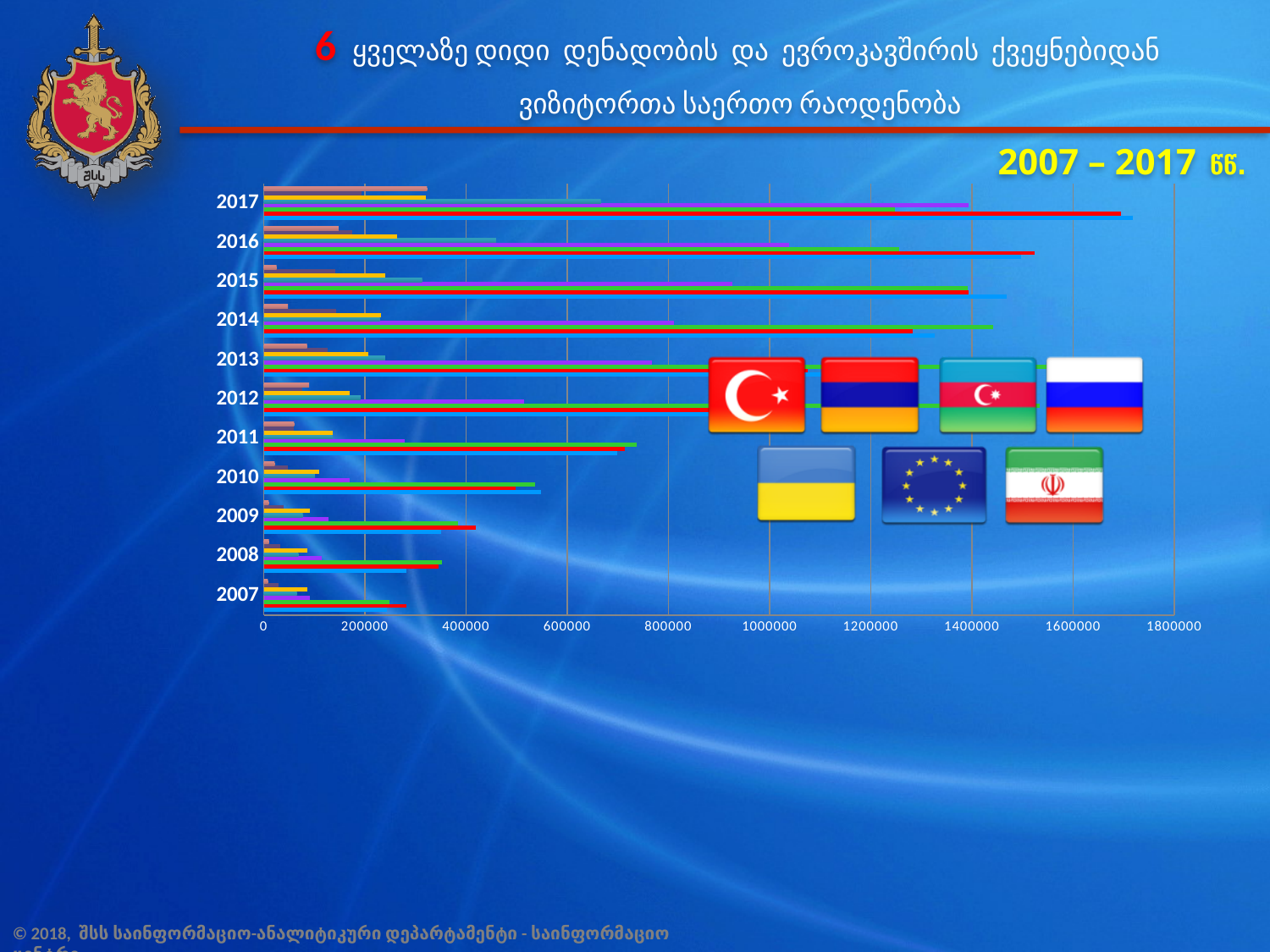
Is the longest bar for 2011 greater or less than 600000? greater Is the longest bar for 2017 greater or less than 1600000? greater How many years are listed on the vertical axis of the chart? 11 Which year has the shortest longest bar in the chart? 2007 Do the longest bars generally rise or fall from 2007 to 2017? rise Is the longest bar for 2016 greater or less than 1400000? greater Which year has a longer longest bar, 2010 or 2011? 2011 What is the highest value shown on the horizontal axis of the chart? 1800000 What kind of chart is shown on the slide? bar chart Which year has the longest bar in the chart? 2017